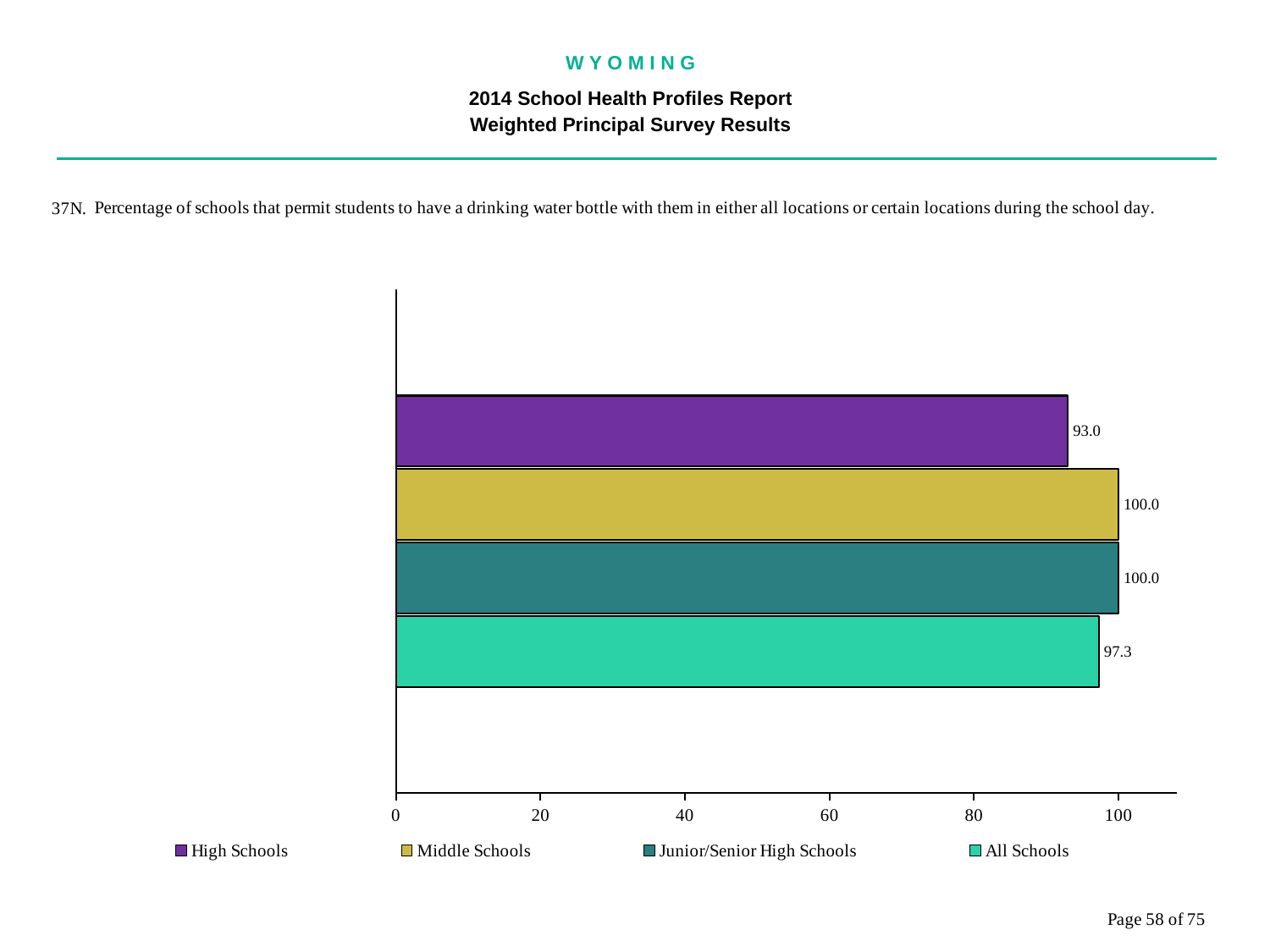
What is the difference between the values for All Schools and High Schools? 4.3 Which category has the lowest value? High Schools What is the difference between the values for Middle Schools and All Schools? 2.7 How many bars are plotted on the chart? 4 What kind of chart is shown on the slide? bar chart How many series does the legend list? 4 Which is larger, the value for All Schools or the value for High Schools? All Schools What is the value for Middle Schools? 100.0 What is the value for Junior/Senior High Schools? 100.0 What is the value for All Schools? 97.3 What is the value for High Schools? 93.0 Is the value for High Schools greater or less than 80? greater